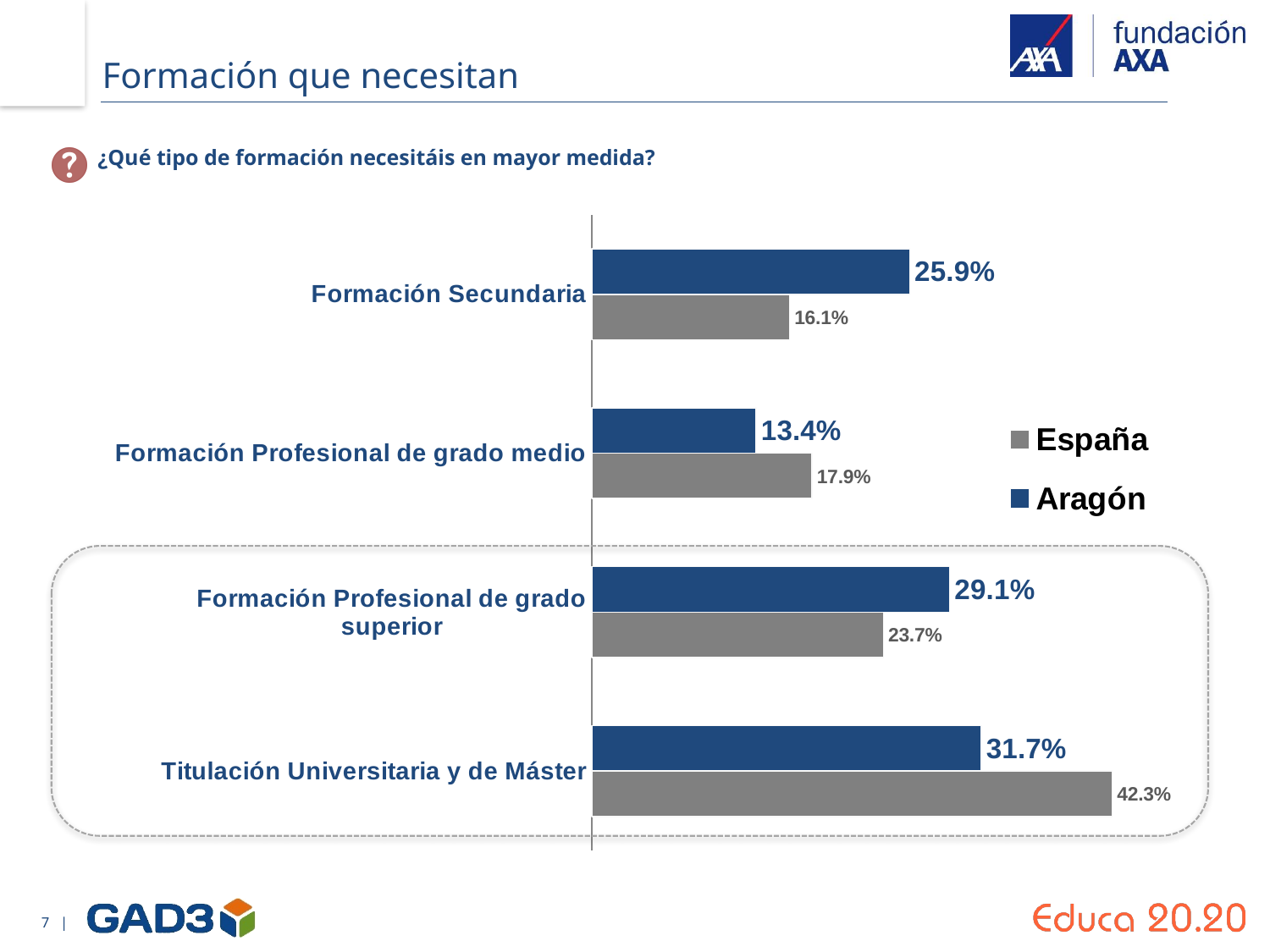
What is the value for Aragón for Formación Secundaria? 25.9% How many series does the legend list? 2 What is the difference between the España and Aragón values for Titulación Universitaria y de Máster? 10.6% Which category has the lowest value for España? Formación Secundaria What is the value for España for Formación Profesional de grado medio? 17.9% Which category has the highest value for Aragón? Titulación Universitaria y de Máster How many categories are shown in the chart? 4 What is the difference between the Aragón and España values for Formación Secundaria? 9.8% For Formación Profesional de grado medio, which is larger: the value for España or for Aragón? España What is the value for Aragón for Formación Profesional de grado superior? 29.1% What is the value for España for Titulación Universitaria y de Máster? 42.3% What kind of chart is shown on the slide? Bar chart